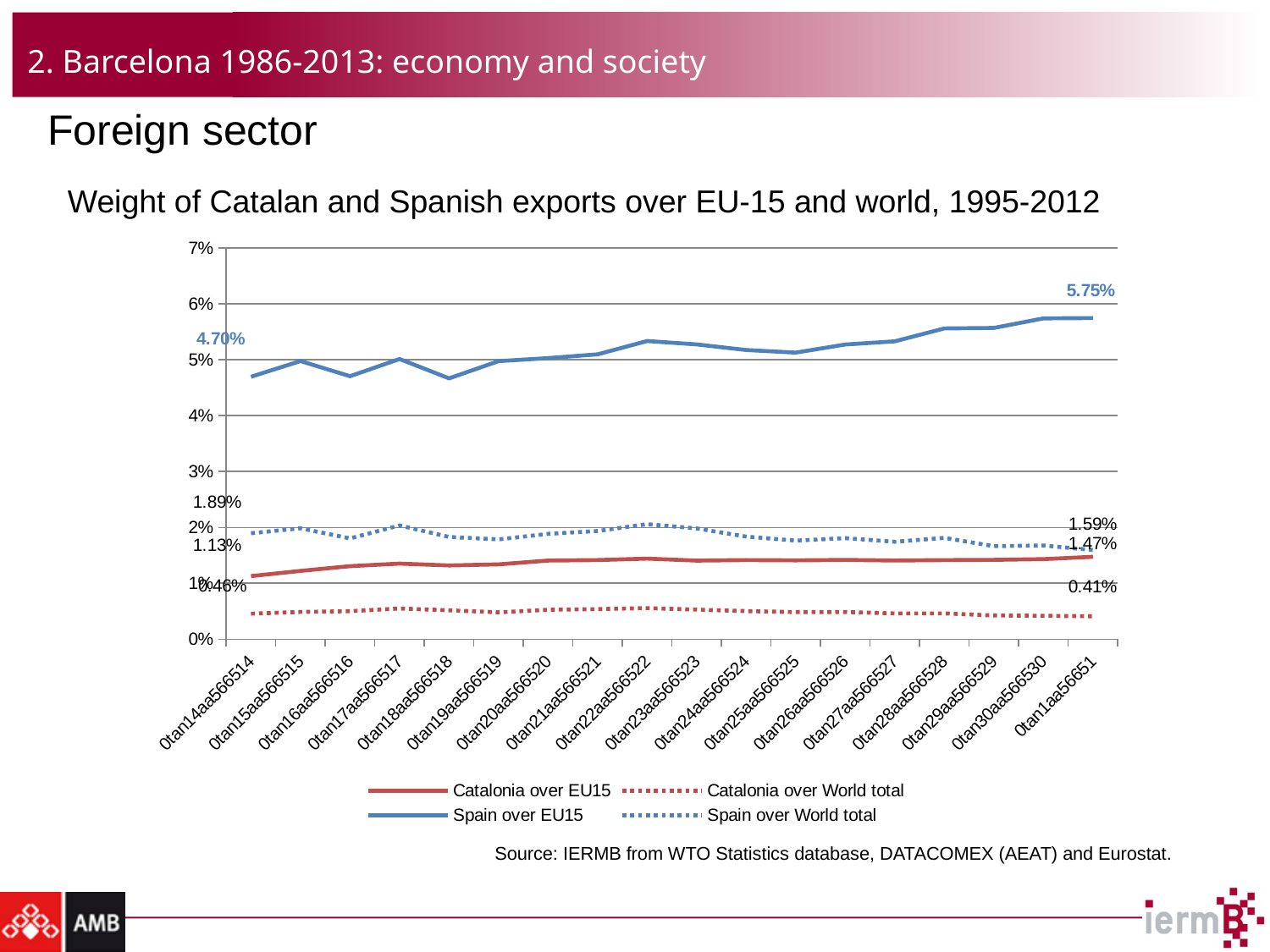
By how much did the Spain over EU15 series change between its first labelled value (4.70%) and its last labelled value (5.75%)? 1.05% What is the last (2012) value labelled for the Spain over EU15 series? 5.75% Which series has the lowest values throughout the chart? Catalonia over World total Does the Spain over World total series rise or fall overall from its first labelled value (1.89%) to its last (1.59%)? fall What kind of chart is shown on the slide? line chart What is the first (1995) value labelled for the Spain over EU15 series? 4.70% Is the last value of the Catalonia over EU15 series greater or less than 2%? less How many series does the legend list? 4 What is the last value labelled for the Catalonia over EU15 series? 1.47% What is the first value labelled for the Catalonia over World total series? 0.46% Which series has the highest values throughout the chart? Spain over EU15 What is the last value labelled for the Spain over World total series? 1.59%